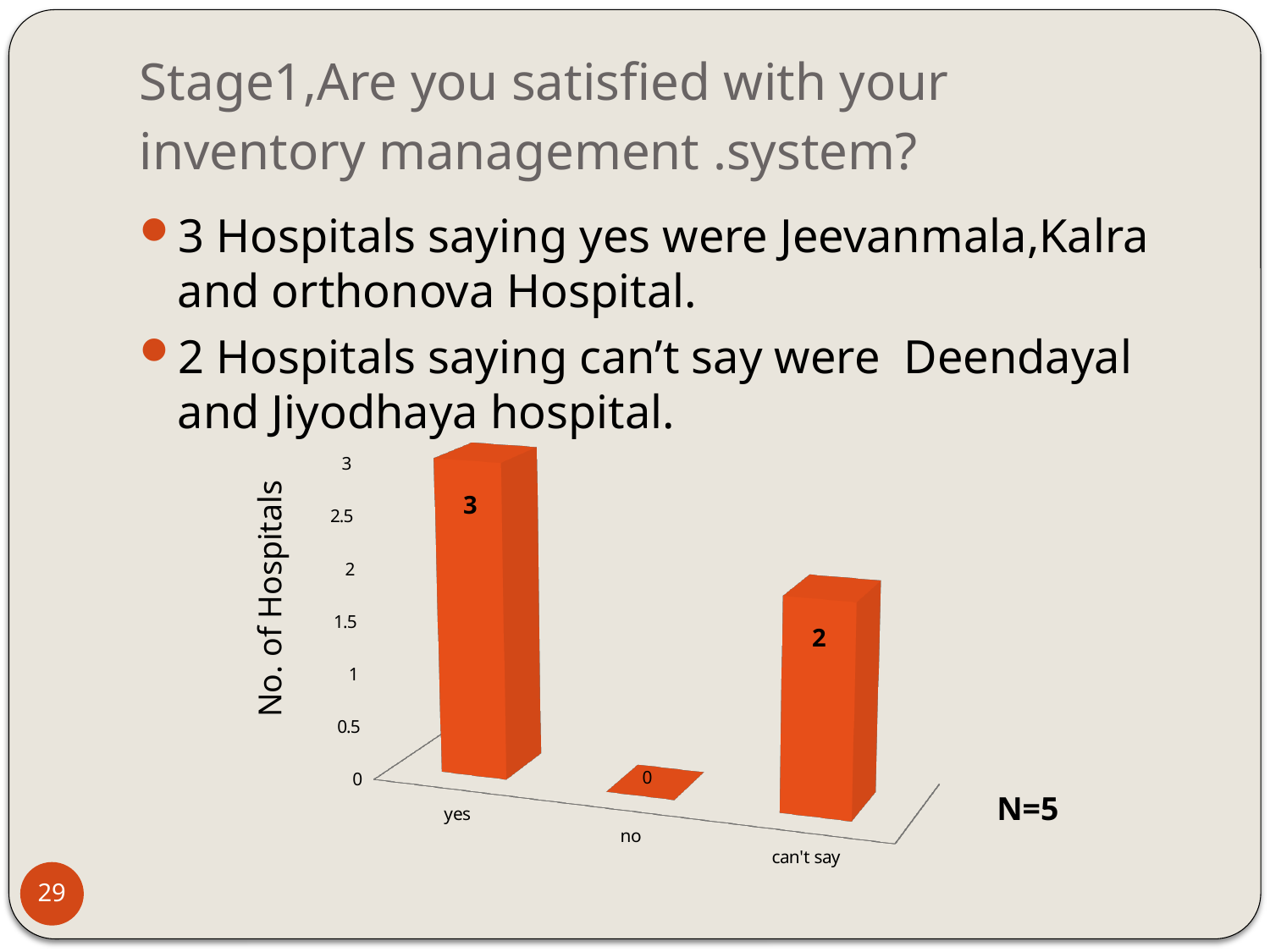
What is the difference between the number of hospitals saying "yes" and those saying "can't say"? 1 What is the total number of hospitals across all three response categories? 5 How many response categories are shown on the x axis? 3 How many hospitals answered "yes"? 3 Which response category has the lowest number of hospitals? no Which has more hospitals, "yes" or "can't say"? yes How many hospitals answered "no"? 0 What is the label of the vertical axis? No. of Hospitals Which response category has the highest number of hospitals? yes How many hospitals answered "can't say"? 2 What sample size (N) is stated next to the chart? N=5 What kind of chart is shown on the slide? bar chart